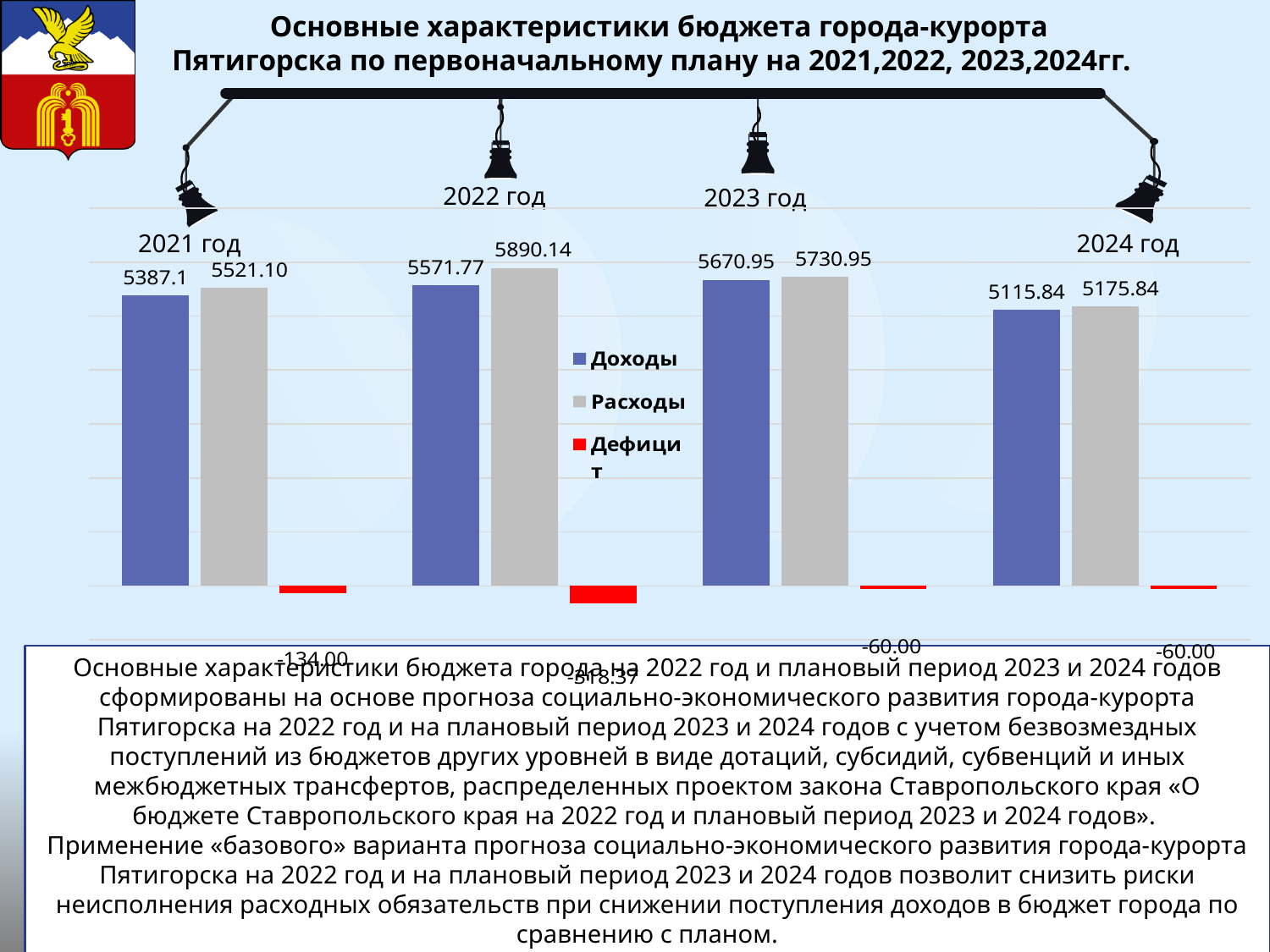
Which is larger for 2022 год: Доходы or Расходы? Расходы Which year has the lowest value of Расходы? 2024 год What is the value of Доходы for 2021 год? 5387.1 What is the value of Расходы for 2024 год? 5175.84 Which year has the highest value of Доходы? 2023 год How many years are shown on the chart? 4 What is the value of Доходы for 2023 год? 5670.95 How many series does the legend list? 3 What is the value of Расходы for 2022 год? 5890.14 Which colour represents Дефицит in the legend? red What kind of chart is shown on the slide? bar chart What is the difference between Расходы and Доходы for 2023 год? 60.00